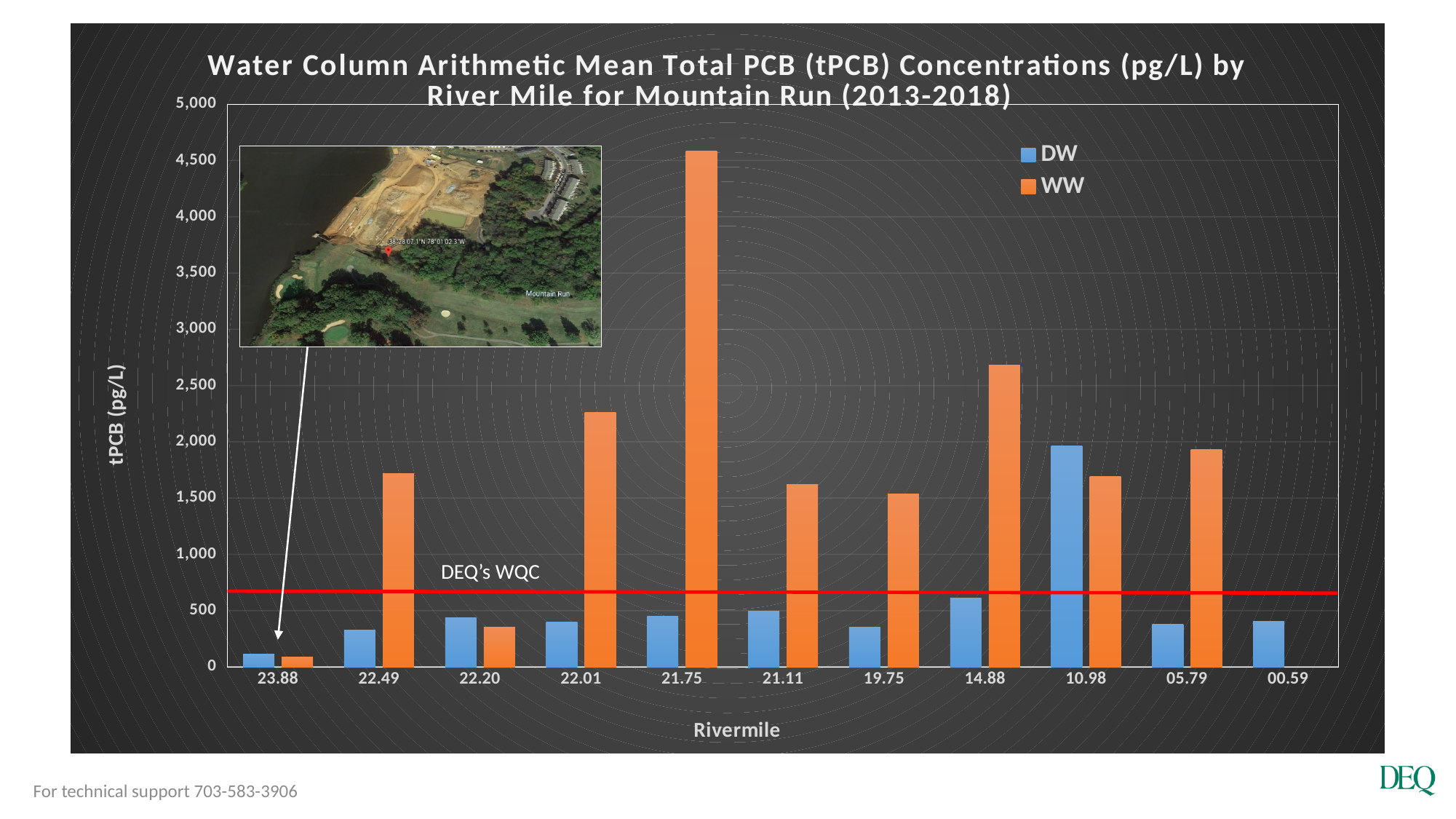
Is the WW value at river mile 14.88 greater or less than 2,500? greater What does the red horizontal line on the chart represent? DEQ's WQC Which river mile has the highest DW value? 10.98 Is the DW value at river mile 22.49 greater or less than 500? less Which river mile has the highest WW value? 21.75 How many river mile categories are shown on the x axis? 11 At river mile 10.98, which series has the larger value, DW or WW? DW How many series does the legend list? 2 Which river mile has the lowest WW value? 23.88 Is the WW value at river mile 21.75 greater or less than 4,000? greater At river mile 22.49, which series has the larger value, DW or WW? WW What kind of chart is shown on the slide? bar chart